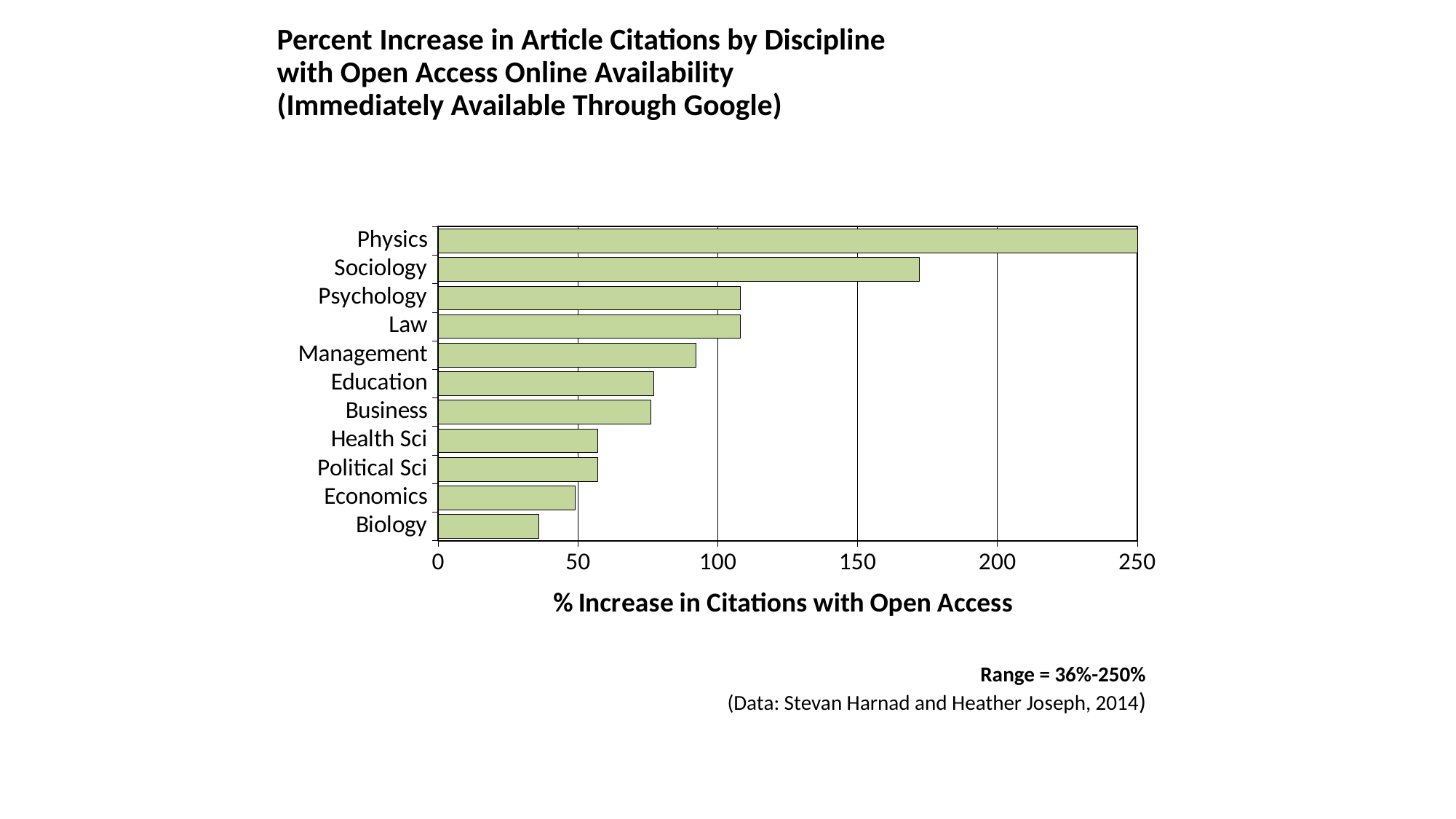
Do the bar values increase or decrease going from the top of the chart (Physics) to the bottom (Biology)? Decrease Which discipline has the lowest percent increase in citations with open access? Biology What is the percent increase in citations for Physics? 250 Is the value for Psychology greater or less than 100? greater Is the value for Management greater or less than 100? less Is the value for Sociology greater or less than 150? greater What kind of chart is shown on the slide? Bar chart What is the title of the horizontal axis? % Increase in Citations with Open Access Which discipline has the highest percent increase in citations with open access? Physics How many disciplines are plotted in the chart? 11 Which has a larger percent increase in citations, Management or Education? Management